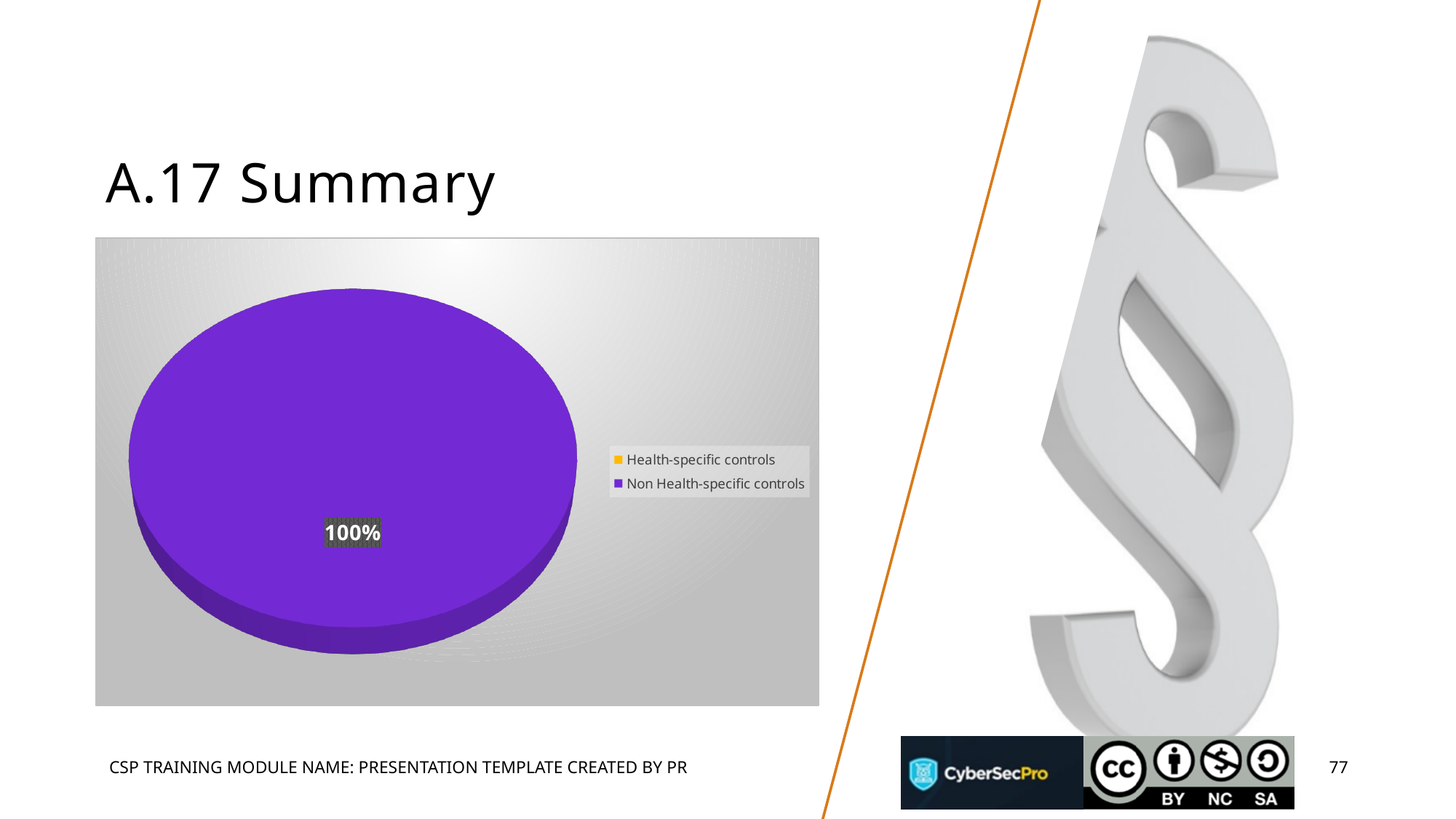
What colour represents Non Health-specific controls in the chart? purple Which is larger, the share for Health-specific controls or the share for Non Health-specific controls? Non Health-specific controls How many slices are visible in the pie? 1 How many categories does the legend list? 2 What value is printed as the data label on the pie? 100% What share of the pie does the Non Health-specific controls slice represent? 100% Which category has the largest share of the pie? Non Health-specific controls What are the two legend entries of the chart? Health-specific controls; Non Health-specific controls What kind of chart is shown on the slide? pie chart